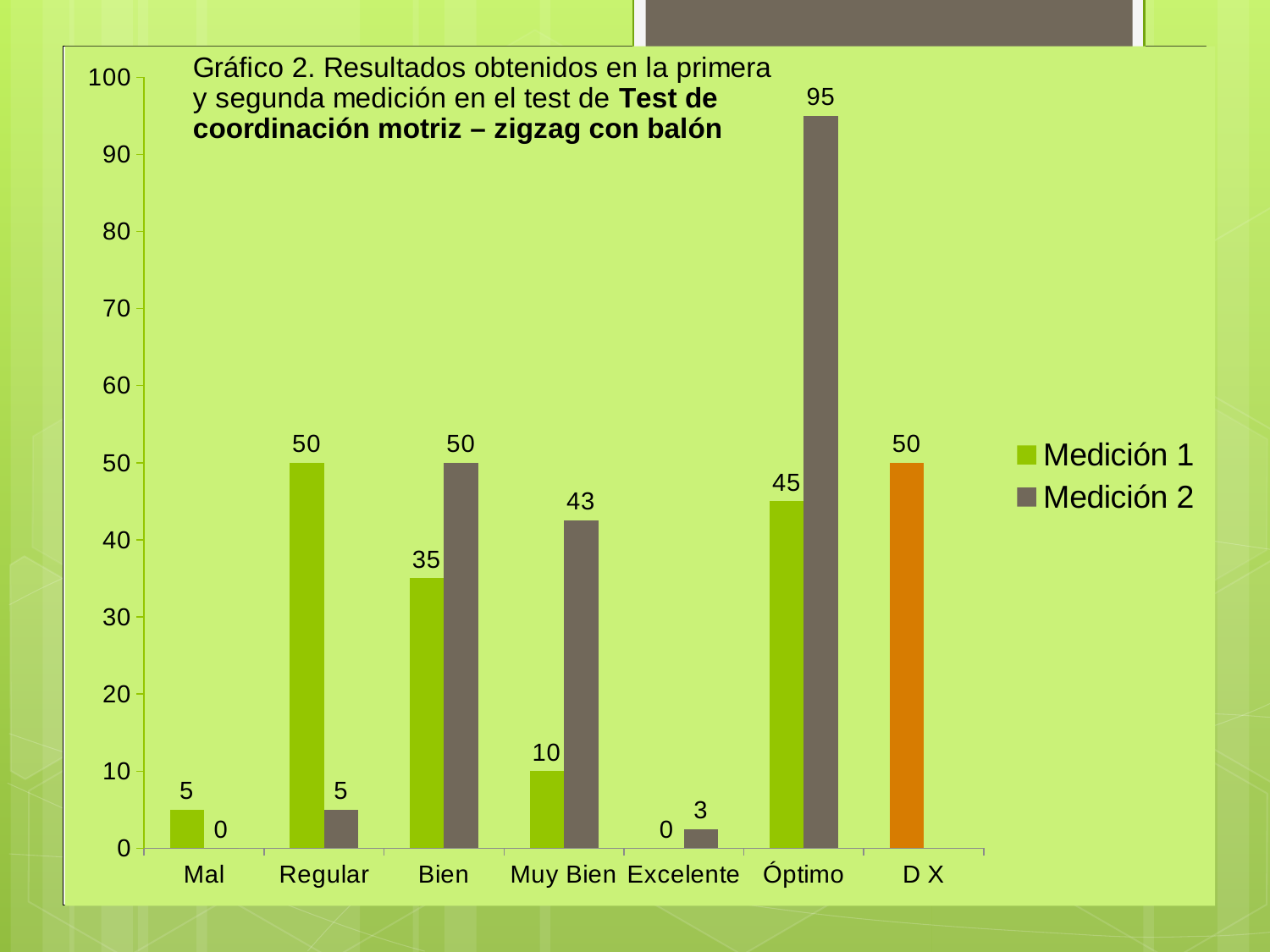
What kind of chart is shown on the slide? Bar chart Which category has the lowest Medición 1 value? Excelente What colour is the bar for Medición 1 in the legend? Green Which category has the highest Medición 2 value? Óptimo How many categories are shown on the x axis? 7 What is the difference between Medición 2 and Medición 1 for Óptimo? 50 What is the value of Medición 2 for Óptimo? 95 What is the value of Medición 2 for Muy Bien? 43 How many series does the legend list? 2 What is the value of Medición 1 for Regular? 50 Which is larger for Regular, Medición 1 or Medición 2? Medición 1 What is the value of Medición 1 for Bien? 35